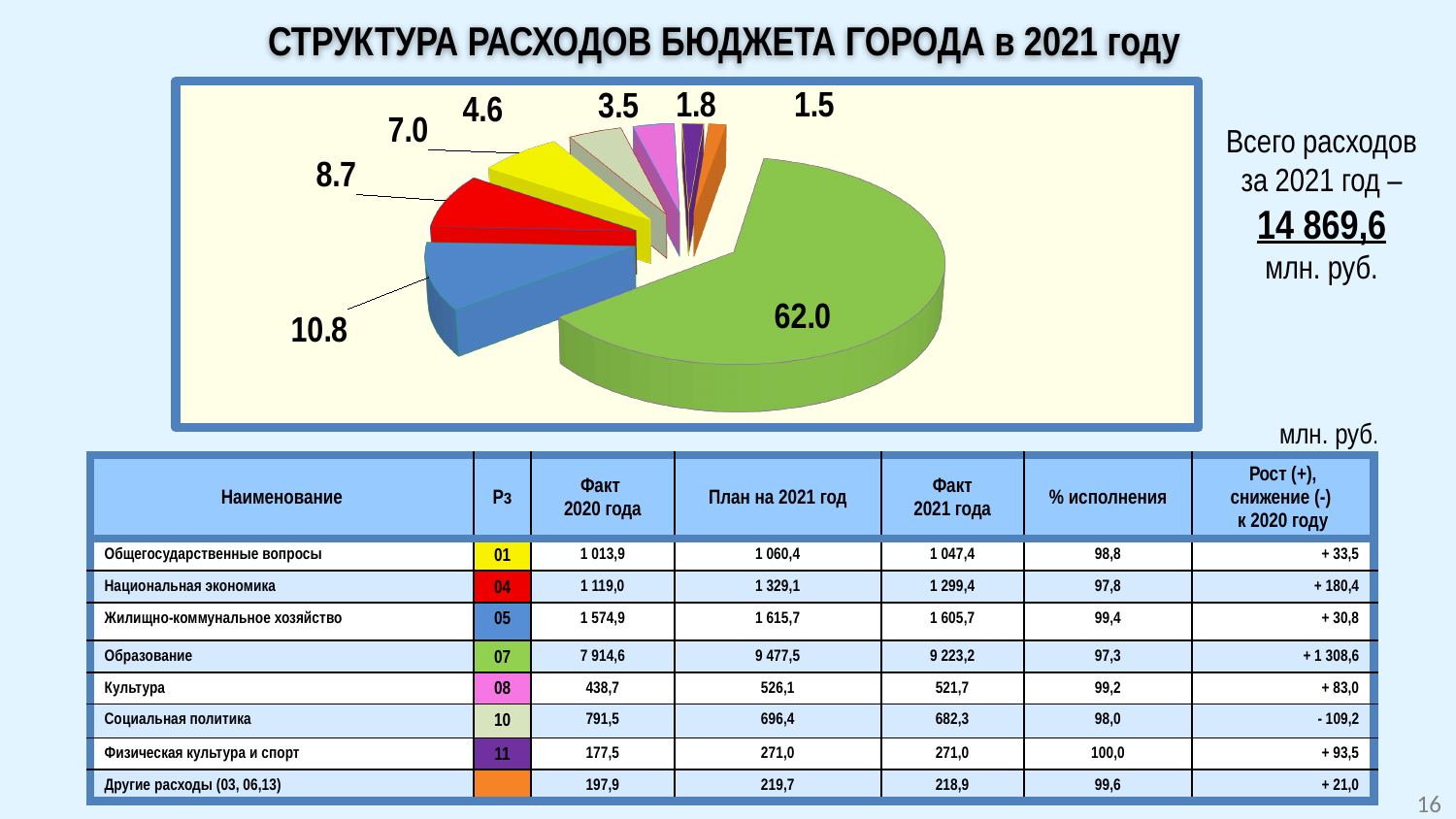
What is the value of the largest slice of the pie chart? 62.0 What is the title of the slide containing the pie chart? СТРУКТУРА РАСХОДОВ БЮДЖЕТА ГОРОДА в 2021 году What value is labelled on the pink slice of the pie chart? 3.5 What value is labelled on the yellow slice of the pie chart? 7.0 What value is labelled on the red slice of the pie chart? 8.7 What is the difference between the blue slice (10.8) and the red slice (8.7) in the pie chart? 2.1 What kind of chart is shown on the slide? pie chart What colour is the largest slice of the pie chart? green What value is labelled on the blue slice of the pie chart? 10.8 How many slices does the pie chart have? 8 What is the value of the smallest slice of the pie chart? 1.5 Which slice is larger in the pie chart, the yellow one or the red one? the red one (8.7)